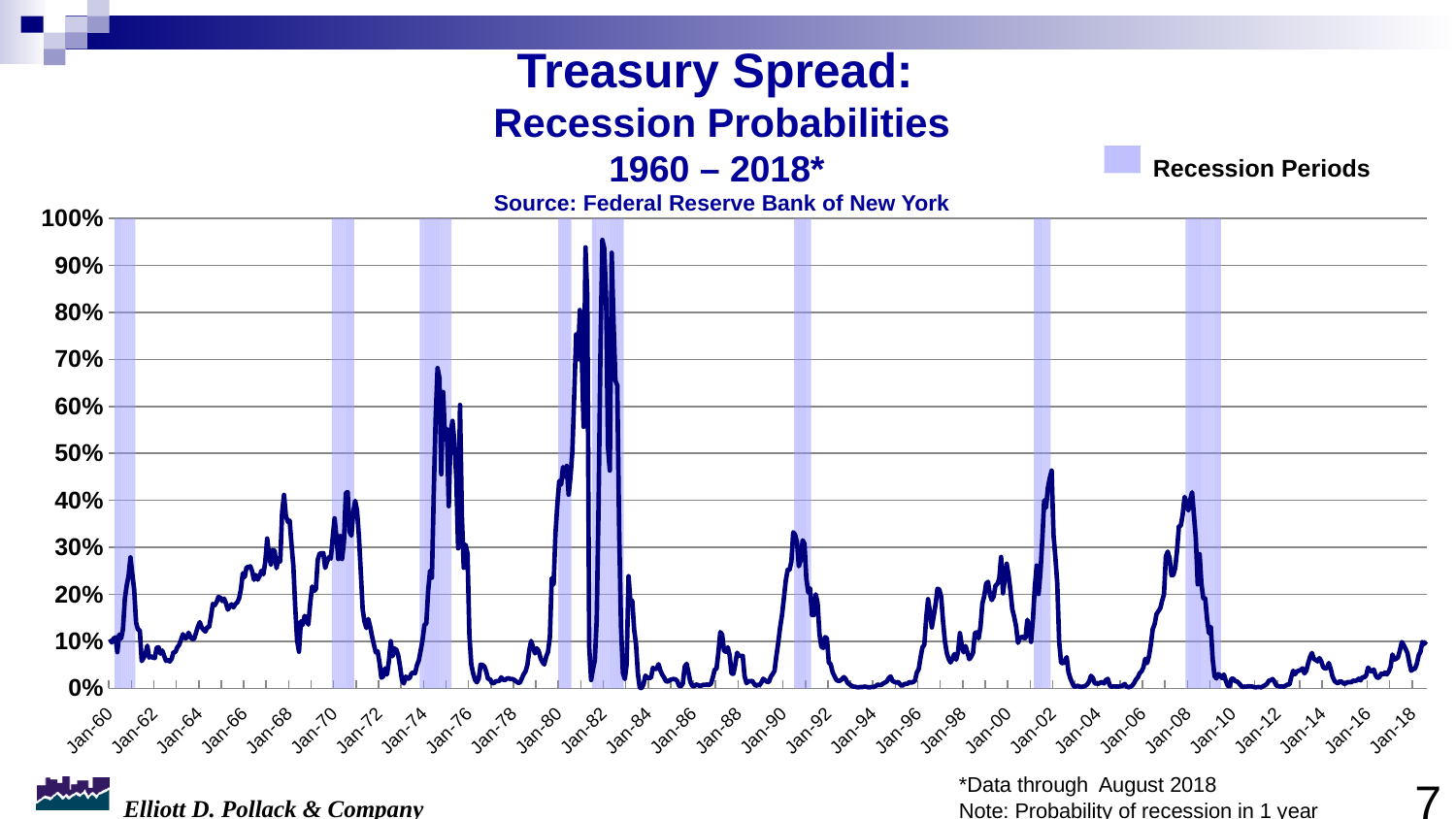
Is the peak recession probability around 1974–1975 greater or less than 60%? greater What is the highest value shown on the y-axis? 100% Is the peak recession probability around 2008 greater or less than 50%? less Does the recession probability rise or fall between Jan-02 and Jan-04? fall What does the shaded legend entry on the chart represent? Recession Periods What is the title of the chart? Treasury Spread: Recession Probabilities 1960 – 2018* What kind of chart is shown on the slide? line chart Is the recession probability at Jan-18 greater or less than 20%? less How many shaded recession periods are marked on the chart? 8 Around which period does the recession probability line reach its highest peak? around 1981–1982 (between Jan-80 and Jan-84) Which peak is higher: the one around 1982 or the one around 2008? the one around 1982